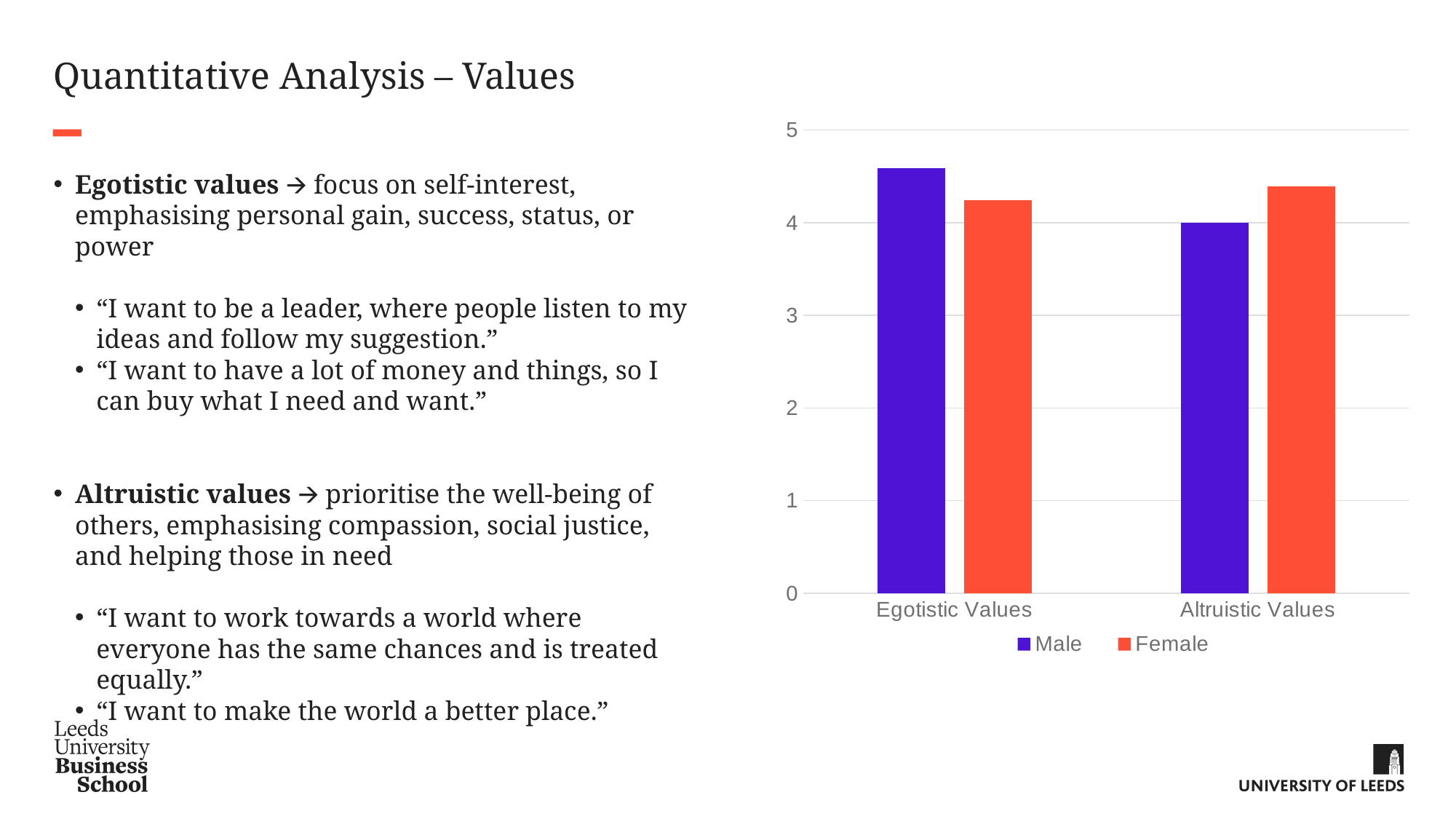
For the Male series, which category has the higher value? Egotistic Values Which series is shown in purple in the chart? Male Which series is shown in orange-red in the chart? Female For Egotistic Values, which is larger, the Male bar or the Female bar? Male Which bar is the tallest in the chart? Male, Egotistic Values For Altruistic Values, which is larger, the Male bar or the Female bar? Female What kind of chart is shown on the slide? bar chart Is the Female value for Altruistic Values greater or less than 5? less Is the Male value for Egotistic Values greater or less than 4? greater How many series does the chart legend list? 2 How many categories are shown on the x axis of the chart? 2 Which bar is the shortest in the chart? Male, Altruistic Values